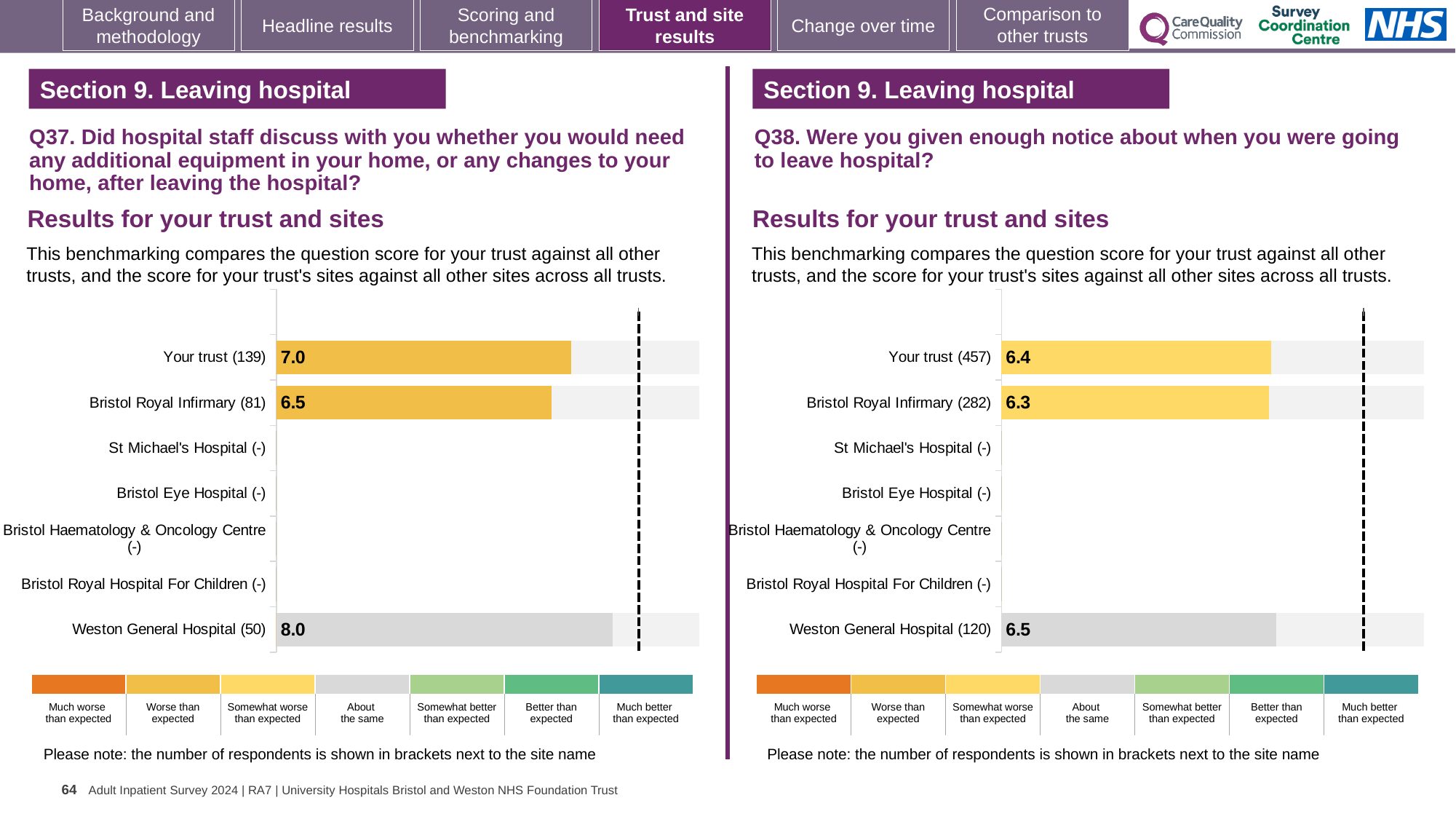
In the Q37 chart on the left, which has the larger score, Your trust (139) or Bristol Royal Infirmary (81)? Your trust (139) In the Q38 chart on the right, what is the difference between the scores for Weston General Hospital (120) and Bristol Royal Infirmary (282)? 0.2 What kind of chart is used for the Q37 results on the left? Bar chart In the Q38 chart on the right, what is the score for Bristol Royal Infirmary (282)? 6.3 In the Q37 chart on the left, what is the score for Your trust (139)? 7.0 In the Q37 chart on the left, what colour category does the bar for Your trust (139) fall into according to the key below the chart? Worse than expected In the Q37 chart on the left, what is the score for Weston General Hospital (50)? 8.0 How many site or trust rows are listed on the vertical axis of the Q38 chart on the right? 7 In the Q38 chart on the right, what is the score for Your trust (457)? 6.4 In the Q37 chart on the left, which site or trust row has the lowest score? Bristol Royal Infirmary (81) In the Q37 chart on the left, what is the difference between the scores for Weston General Hospital (50) and Your trust (139)? 1.0 In the Q37 chart on the left, which site or trust row has the highest score? Weston General Hospital (50)